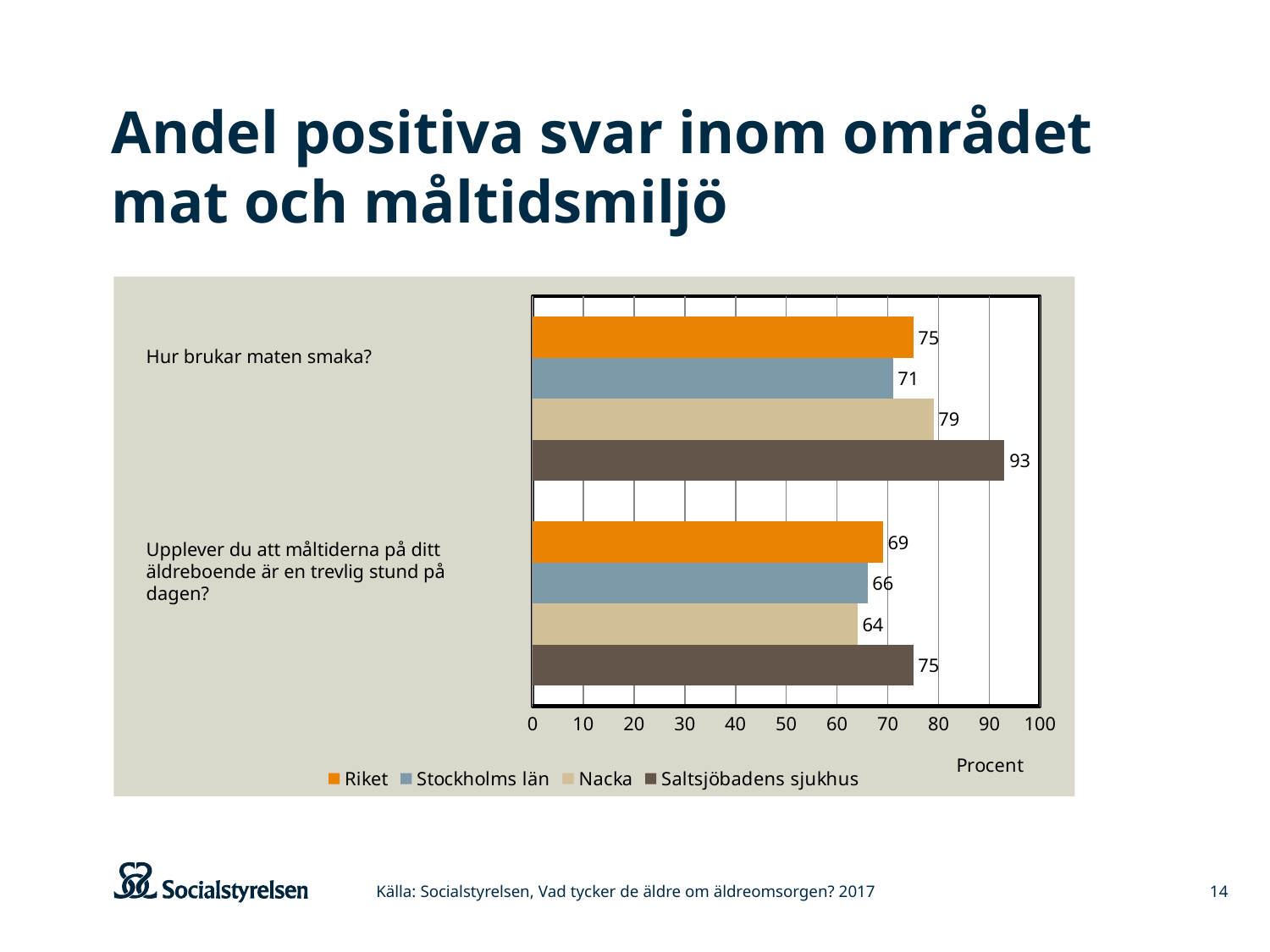
What is the value for Saltsjöbadens sjukhus for the question "Hur brukar maten smaka?"? 93 How many series does the legend list? 4 What is the value for Riket for the question "Hur brukar maten smaka?"? 75 Which series has the highest value for the question "Hur brukar maten smaka?"? Saltsjöbadens sjukhus Which is larger for the question "Upplever du att måltiderna på ditt äldreboende är en trevlig stund på dagen?": Riket or Nacka? Riket What is the value for Stockholms län for the question "Upplever du att måltiderna på ditt äldreboende är en trevlig stund på dagen?"? 66 What unit is shown on the x axis of the chart? Procent What is the value for Nacka for the question "Upplever du att måltiderna på ditt äldreboende är en trevlig stund på dagen?"? 64 How many questions (categories) are shown on the chart? 2 What kind of chart is shown on the slide? Bar chart What is the difference between Saltsjöbadens sjukhus and Riket for the question "Hur brukar maten smaka?"? 18 Which series has the lowest value for the question "Upplever du att måltiderna på ditt äldreboende är en trevlig stund på dagen?"? Nacka